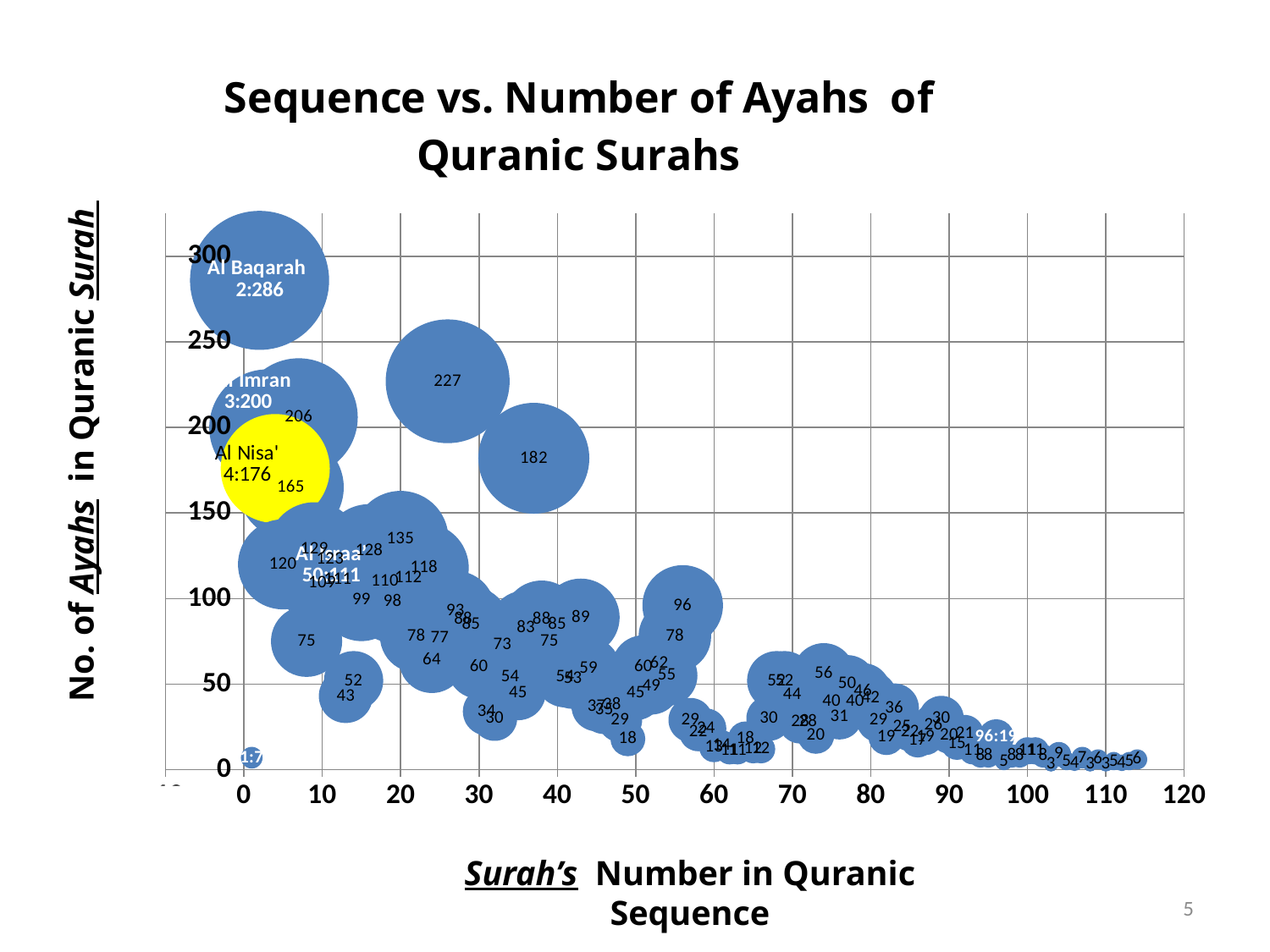
Is the number of ayahs for the bubble labelled 182 greater or less than 200? less Which surah has the highest number of ayahs in the chart? Al Baqarah What is the difference in number of ayahs between Al Baqarah and Al Imran? 86 Which has more ayahs, Al Imran or Al Nisa'? Al Imran Is the number of ayahs for Al Baqarah greater or less than 250? greater How many ayahs does the chart show for Al Imran? 200 As the surah's number in the Quranic sequence increases, does the number of ayahs generally rise or fall? fall What is the title of the chart? Sequence vs. Number of Ayahs of Quranic Surahs What kind of chart is shown on the slide? Bubble chart How many ayahs does the chart show for Al Baqarah? 286 How many ayahs does the chart show for Al Nisa'? 176 Which surah is highlighted with a yellow bubble? Al Nisa'